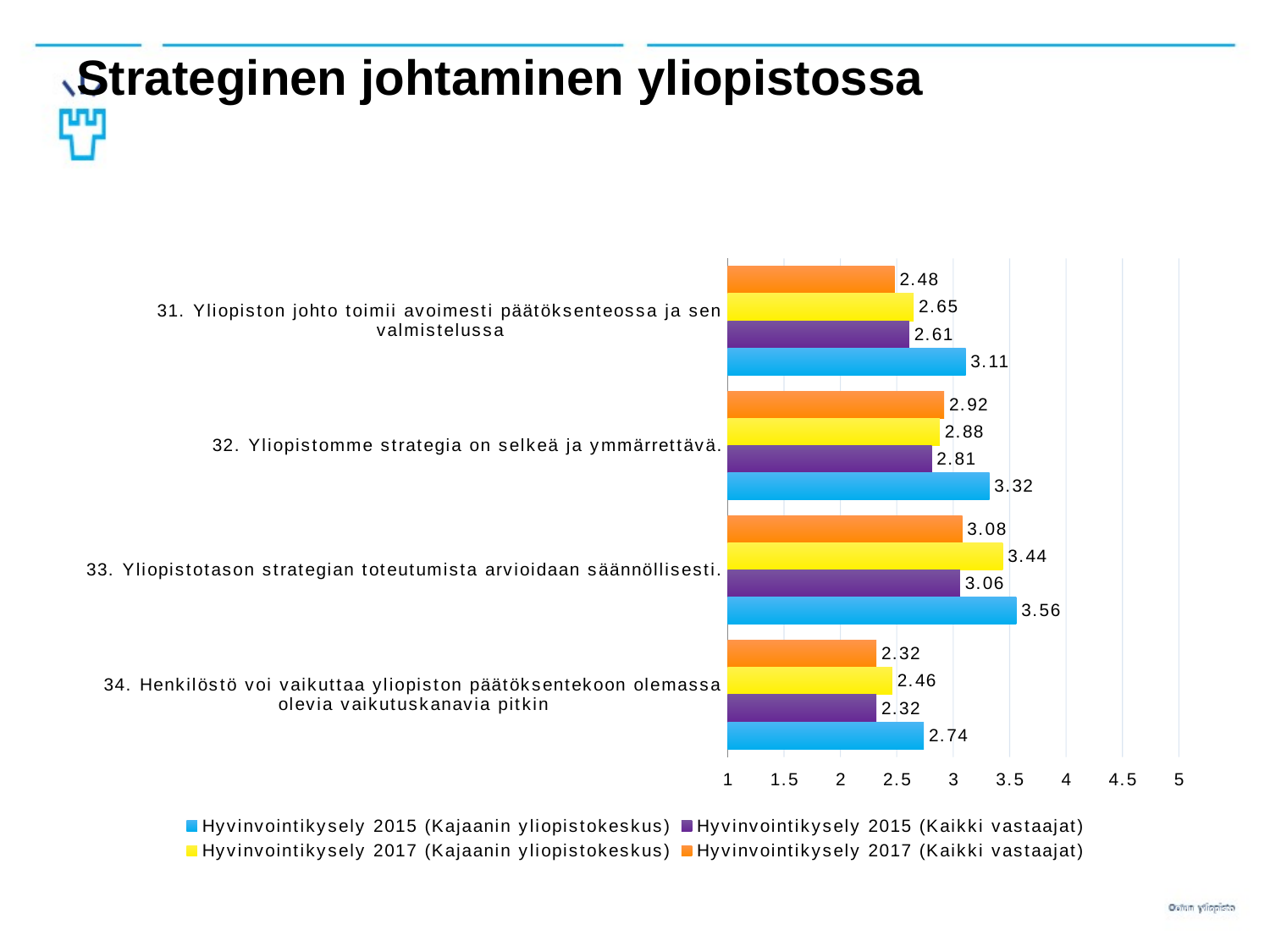
What is the value for Hyvinvointikysely 2015 (Kajaanin yliopistokeskus) for statement 31 (Yliopiston johto toimii avoimesti päätöksenteossa ja sen valmistelussa)? 3.11 What is the difference between the Hyvinvointikysely 2015 (Kajaanin yliopistokeskus) and Hyvinvointikysely 2017 (Kajaanin yliopistokeskus) values for statement 31? 0.46 What kind of chart is shown on the slide? Bar chart What is the value for Hyvinvointikysely 2017 (Kaikki vastaajat) for statement 32 (Yliopistomme strategia on selkeä ja ymmärrettävä)? 2.92 Which statement has the lowest value for Hyvinvointikysely 2017 (Kaikki vastaajat)? 34. Henkilöstö voi vaikuttaa yliopiston päätöksentekoon olemassa olevia vaikutuskanavia pitkin What is the value for Hyvinvointikysely 2017 (Kajaanin yliopistokeskus) for statement 33 (Yliopistotason strategian toteutumista arvioidaan säännöllisesti)? 3.44 Which statement has the highest value for Hyvinvointikysely 2015 (Kajaanin yliopistokeskus)? 33. Yliopistotason strategian toteutumista arvioidaan säännöllisesti. For statement 33, which is larger: the Hyvinvointikysely 2017 (Kajaanin yliopistokeskus) value or the Hyvinvointikysely 2017 (Kaikki vastaajat) value? Hyvinvointikysely 2017 (Kajaanin yliopistokeskus) How many series does the legend list? 4 What is the value for Hyvinvointikysely 2015 (Kaikki vastaajat) for statement 34 (Henkilöstö voi vaikuttaa yliopiston päätöksentekoon olemassa olevia vaikutuskanavia pitkin)? 2.32 How many statements (categories) are plotted on the chart? 4 Which colour represents Hyvinvointikysely 2017 (Kajaanin yliopistokeskus) in the chart? Yellow